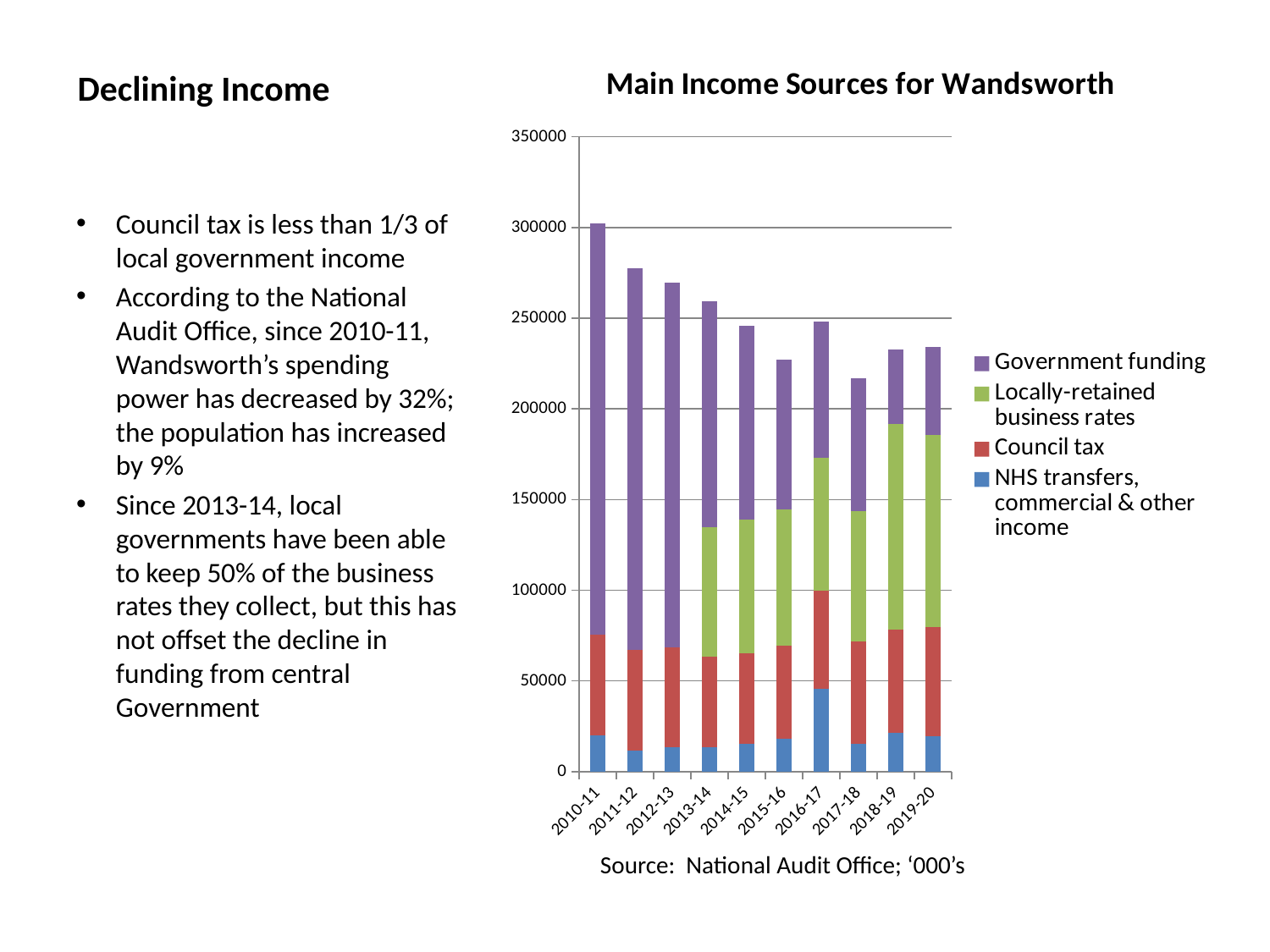
Which year has the shortest total bar in the chart? 2017-18 Which is larger, the Government funding segment in 2010-11 or in 2019-20? 2010-11 What kind of chart is shown on the slide? Stacked bar chart How many years (bars) are shown on the x axis of the chart? 10 Which colour represents Council tax in the chart? Red What is the title of the chart? Main Income Sources for Wandsworth Is the total bar for 2017-18 greater or less than 250000? less Is the total bar for 2010-11 greater or less than 250000? greater Which year has the tallest total bar in the chart? 2010-11 How many series does the chart's legend list? 4 Do the total bar heights generally rise or fall from 2010-11 to 2017-18? fall Which is larger, the total bar for 2010-11 or the total bar for 2019-20? 2010-11